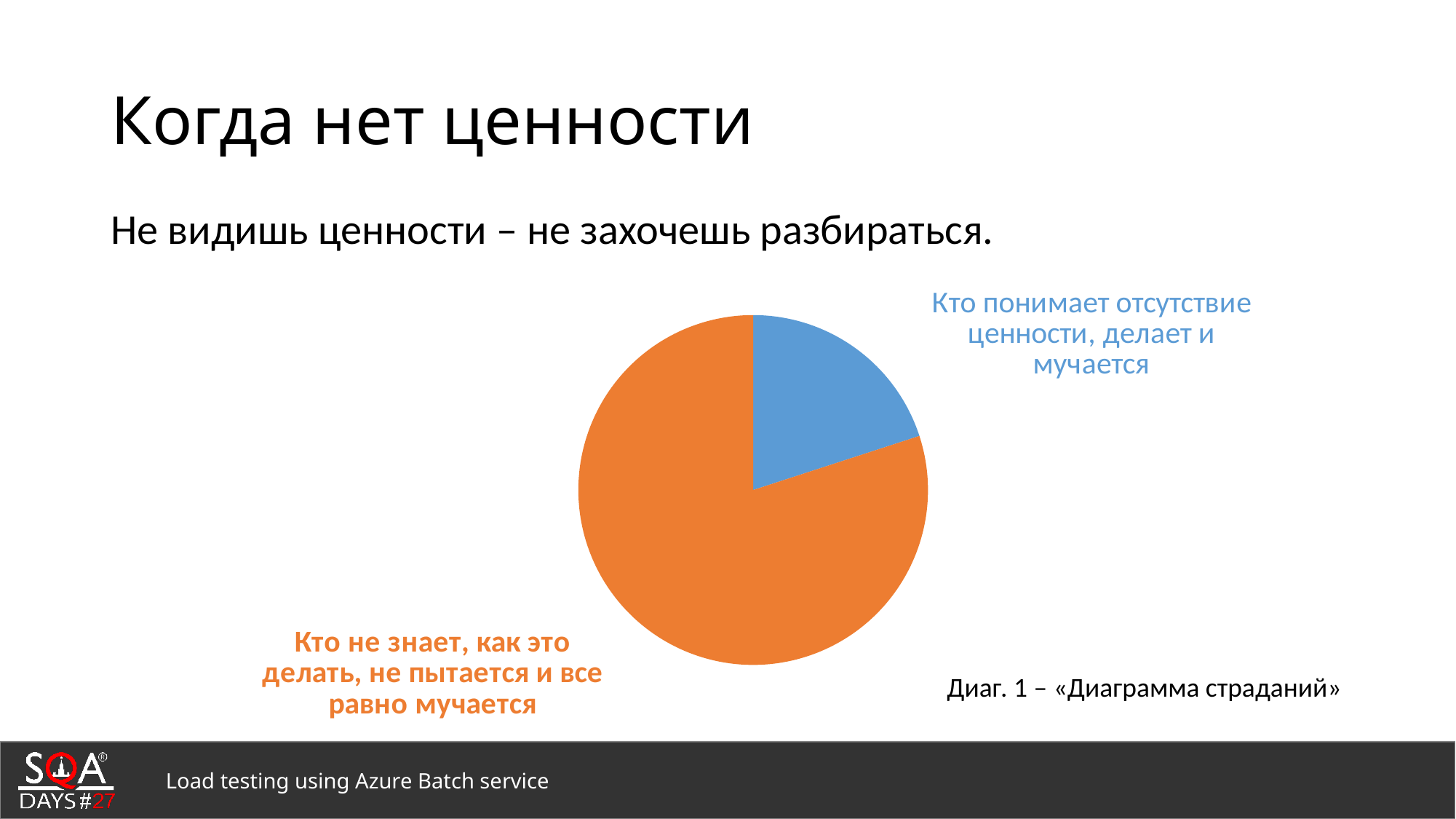
Which slice of the pie chart is the largest? Кто не знает, как это делать, не пытается и все равно мучается Does the slice "Кто понимает отсутствие ценности, делает и мучается" take up more or less than half of the pie? less Which slice is larger: "Кто понимает отсутствие ценности, делает и мучается" or "Кто не знает, как это делать, не пытается и все равно мучается"? Кто не знает, как это делать, не пытается и все равно мучается What colour is the slice labelled "Кто понимает отсутствие ценности, делает и мучается"? blue How many slices does the pie chart have? 2 What is the caption given for the pie chart? Диаг. 1 – «Диаграмма страданий» Which slice of the pie chart is the smallest? Кто понимает отсутствие ценности, делает и мучается What kind of chart is shown on the slide? pie chart